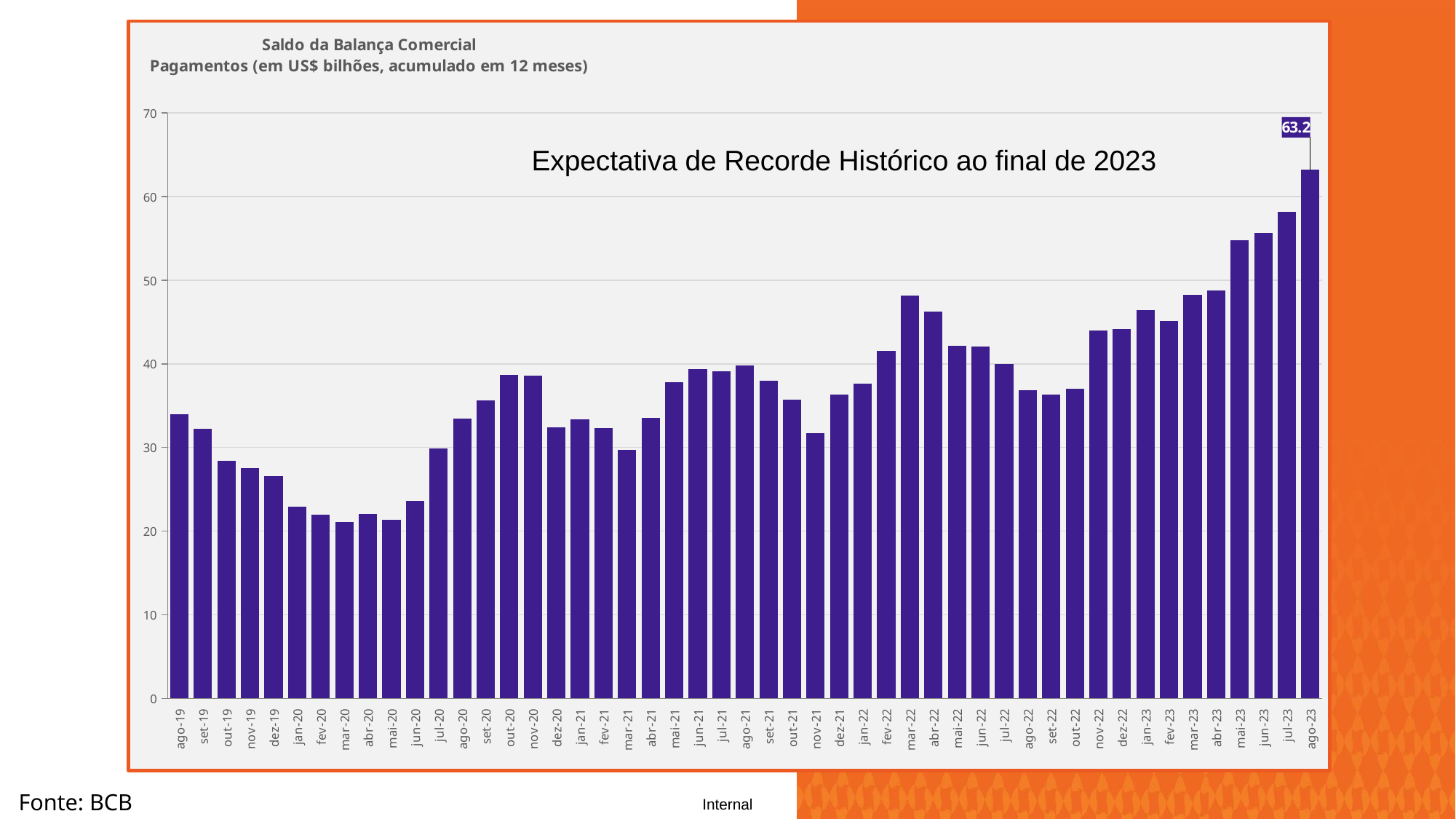
Is the value for ago-19 greater or less than 30? greater What kind of chart is shown on the slide? bar chart Which is larger, the value for ago-19 or the value for set-19? ago-19 Is the value for mar-22 greater or less than 50? less Is the value for mar-20 greater or less than 30? less Do the values rise or fall from out-22 to ago-23? rise What is the value for ago-23? 63.2 How many monthly bars are plotted in the chart? 49 What is the title of the chart? Saldo da Balança Comercial Pagamentos (em US$ bilhões, acumulado em 12 meses) What is the source cited for the chart? BCB Which month has the highest value? ago-23